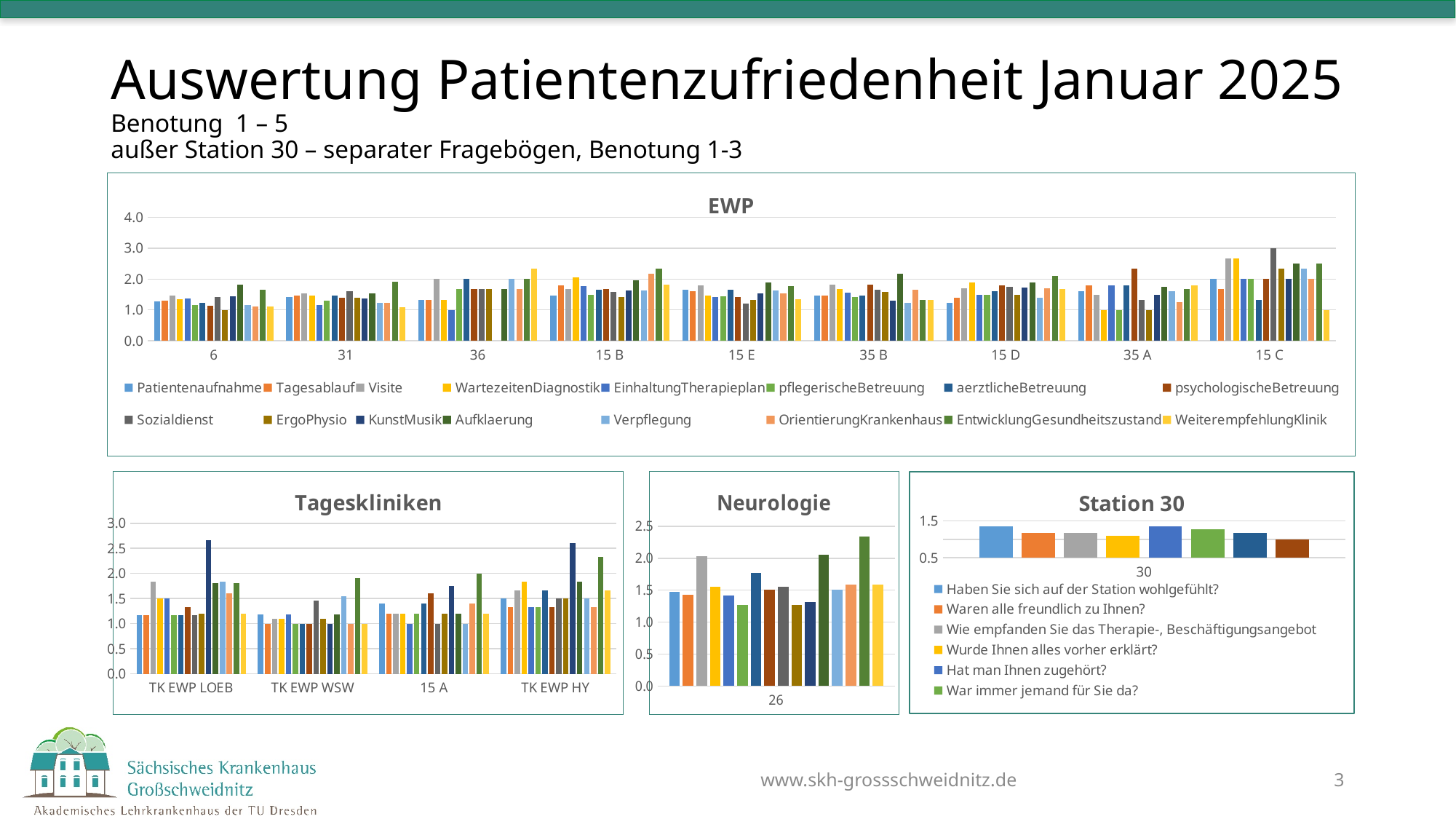
In the EWP chart, is the value for Aufklaerung at station 6 greater or less than 2.0? less How many categories are shown on the x axis of the Tageskliniken chart? 4 In the EWP chart, is the tallest bar for station 15 C greater or less than 2.5? greater In the Neurologie chart, is the tallest bar greater or less than 2.0? greater How many entries does the legend of the Station 30 chart list? 6 What category label appears on the x axis of the Neurologie chart? 26 How many series does the legend of the EWP chart list? 16 What kind of chart is the EWP chart? bar chart How many stations (categories) are shown on the x axis of the EWP chart? 9 What is the title of the chart at the bottom right of the slide? Station 30